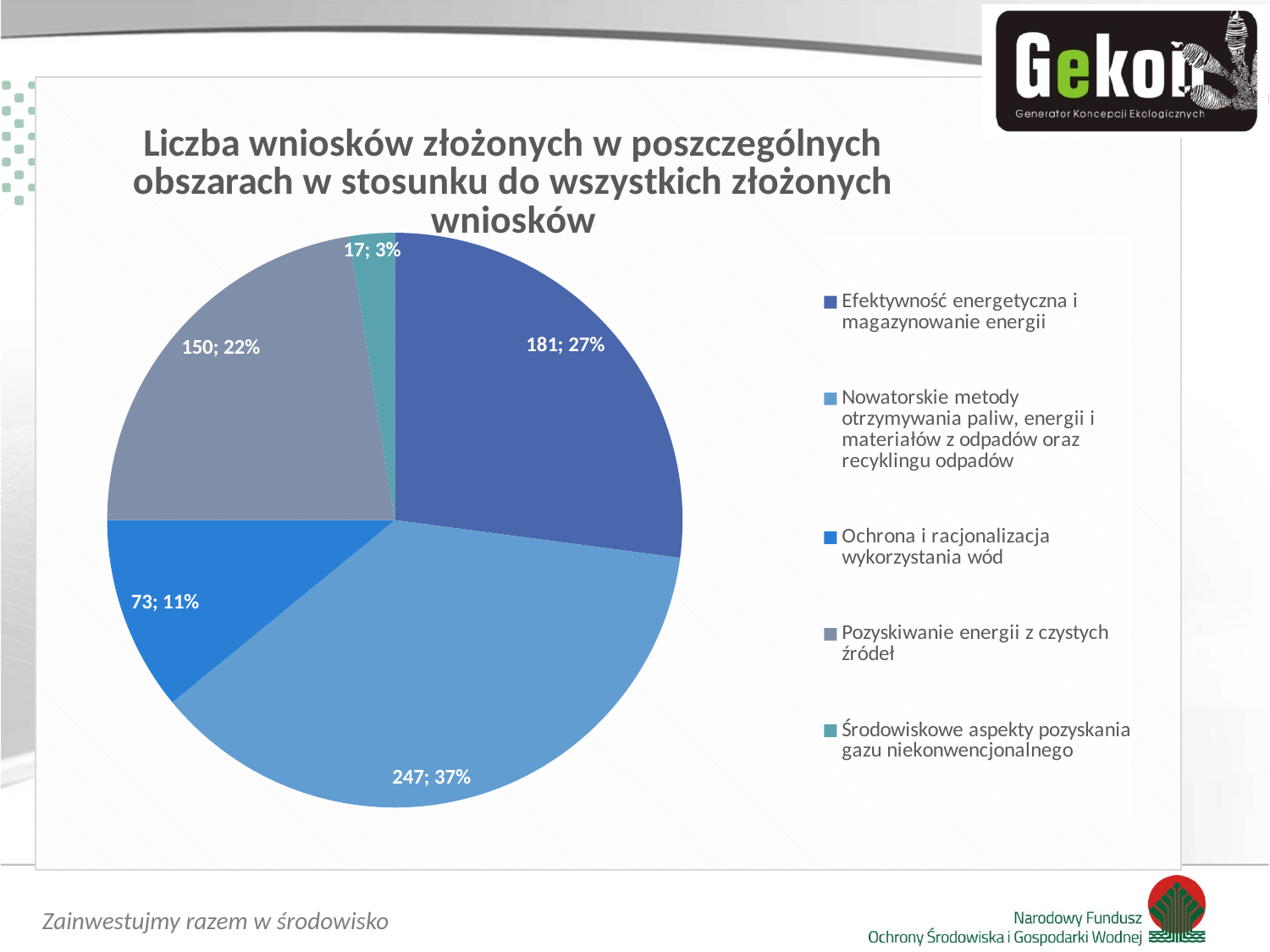
What is the difference in the number of applications between 'Efektywność energetyczna i magazynowanie energii' and 'Pozyskiwanie energii z czystych źródeł'? 31 What is the title of the chart? Liczba wniosków złożonych w poszczególnych obszarach w stosunku do wszystkich złożonych wniosków How many applications were submitted in the area 'Efektywność energetyczna i magazynowanie energii'? 181 Which area has the largest number of applications? Nowatorskie metody otrzymywania paliw, energii i materiałów z odpadów oraz recyklingu odpadów How many slices does the pie chart have? 5 What percentage share does 'Pozyskiwanie energii z czystych źródeł' have? 22% What share of all applications does 'Nowatorskie metody otrzymywania paliw, energii i materiałów z odpadów oraz recyklingu odpadów' represent? 37% How many applications were submitted in the area 'Ochrona i racjonalizacja wykorzystania wód'? 73 What kind of chart is shown on the slide? Pie chart Which area has the smallest number of applications? Środowiskowe aspekty pozyskania gazu niekonwencjonalnego Which has more applications: 'Ochrona i racjonalizacja wykorzystania wód' or 'Środowiskowe aspekty pozyskania gazu niekonwencjonalnego'? Ochrona i racjonalizacja wykorzystania wód How many entries does the legend list? 5